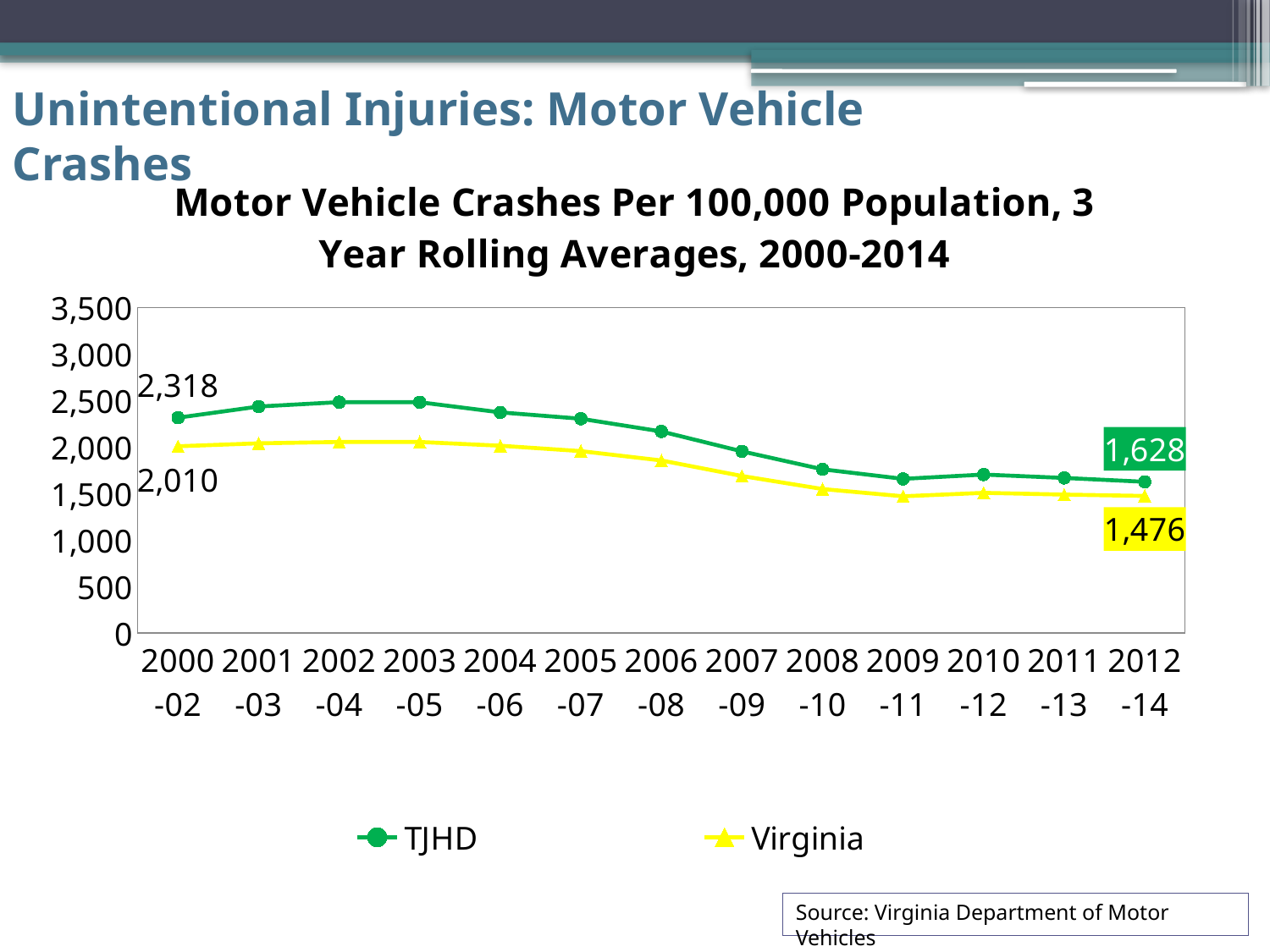
How many series does the legend list? 2 What is the TJHD value for 2000-02? 2,318 What is the TJHD value for 2012-14? 1,628 What kind of chart is this? line chart Do the TJHD values generally rise or fall from 2003-05 to 2012-14? fall What is the Virginia value for 2000-02? 2,010 What is the difference between the TJHD values for 2000-02 and 2012-14? 690 Which series has the higher value in 2012-14, TJHD or Virginia? TJHD What is the Virginia value for 2012-14? 1,476 Is the Virginia value for 2009-11 greater or less than 2,000? less What is the difference between the TJHD and Virginia values for 2012-14? 152 How many time periods are shown on the x axis? 13